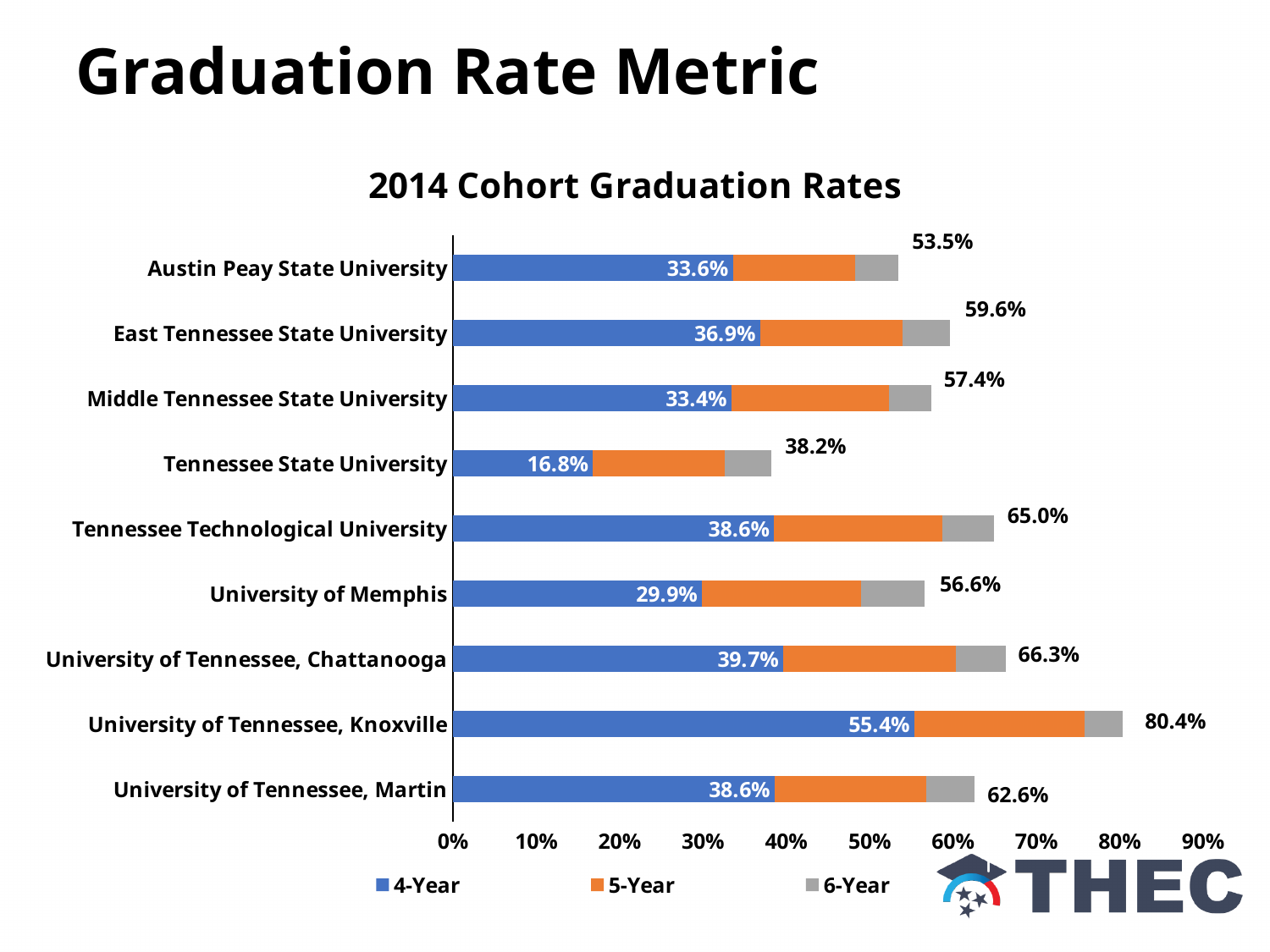
How many series does the legend list? 3 What total value is printed at the end of the bar for University of Tennessee, Knoxville? 80.4% What type of chart is shown on the slide? Stacked bar chart Which university has the highest 4-Year graduation rate? University of Tennessee, Knoxville How many universities are shown in the chart? 9 Which has the higher 4-Year graduation rate, East Tennessee State University or Middle Tennessee State University? East Tennessee State University How much higher is the 4-Year rate for University of Tennessee, Knoxville than for University of Tennessee, Chattanooga? 15.7 percentage points What total value is printed at the end of the bar for University of Tennessee, Martin? 62.6% Which university has the lowest total graduation rate printed at the end of its bar? Tennessee State University What is the 4-Year graduation rate shown for Tennessee State University? 16.8% What is the 4-Year graduation rate shown for University of Tennessee, Chattanooga? 39.7% What is the difference between the total printed for University of Tennessee, Knoxville and the total printed for Tennessee State University? 42.2 percentage points